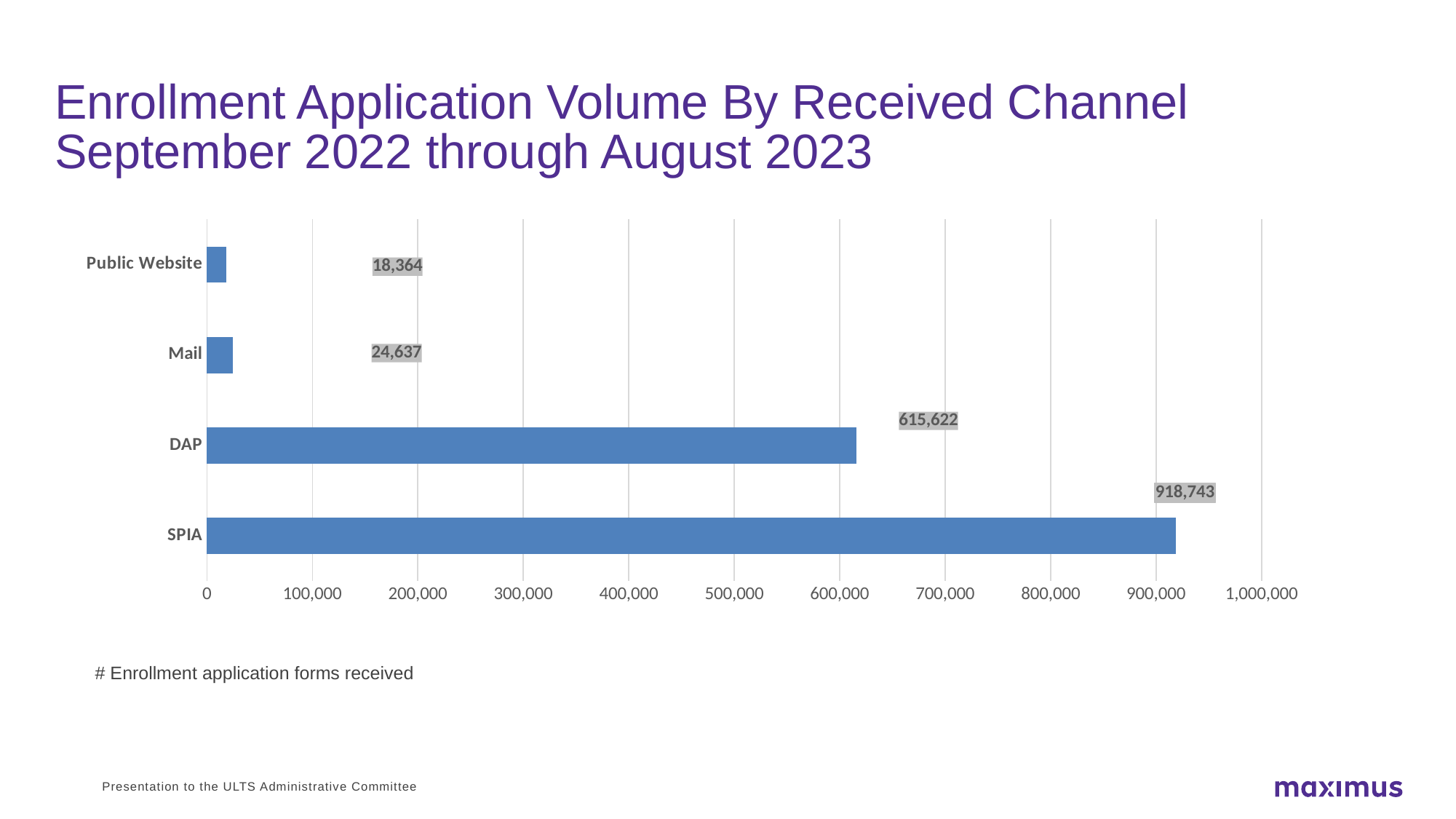
Which channel has the highest volume? SPIA What is the value for Public Website? 18,364 What is the difference between the SPIA and DAP values? 303,121 What is the difference between the Mail and Public Website values? 6,273 What is the value for Mail? 24,637 What is the value for DAP? 615,622 What is the value for SPIA? 918,743 What kind of chart is shown on the slide? Bar chart How many channels are shown in the chart? 4 Which channel has the lowest volume? Public Website Is the value for DAP greater or less than 500,000? greater Which is larger, the value for Mail or the value for Public Website? Mail